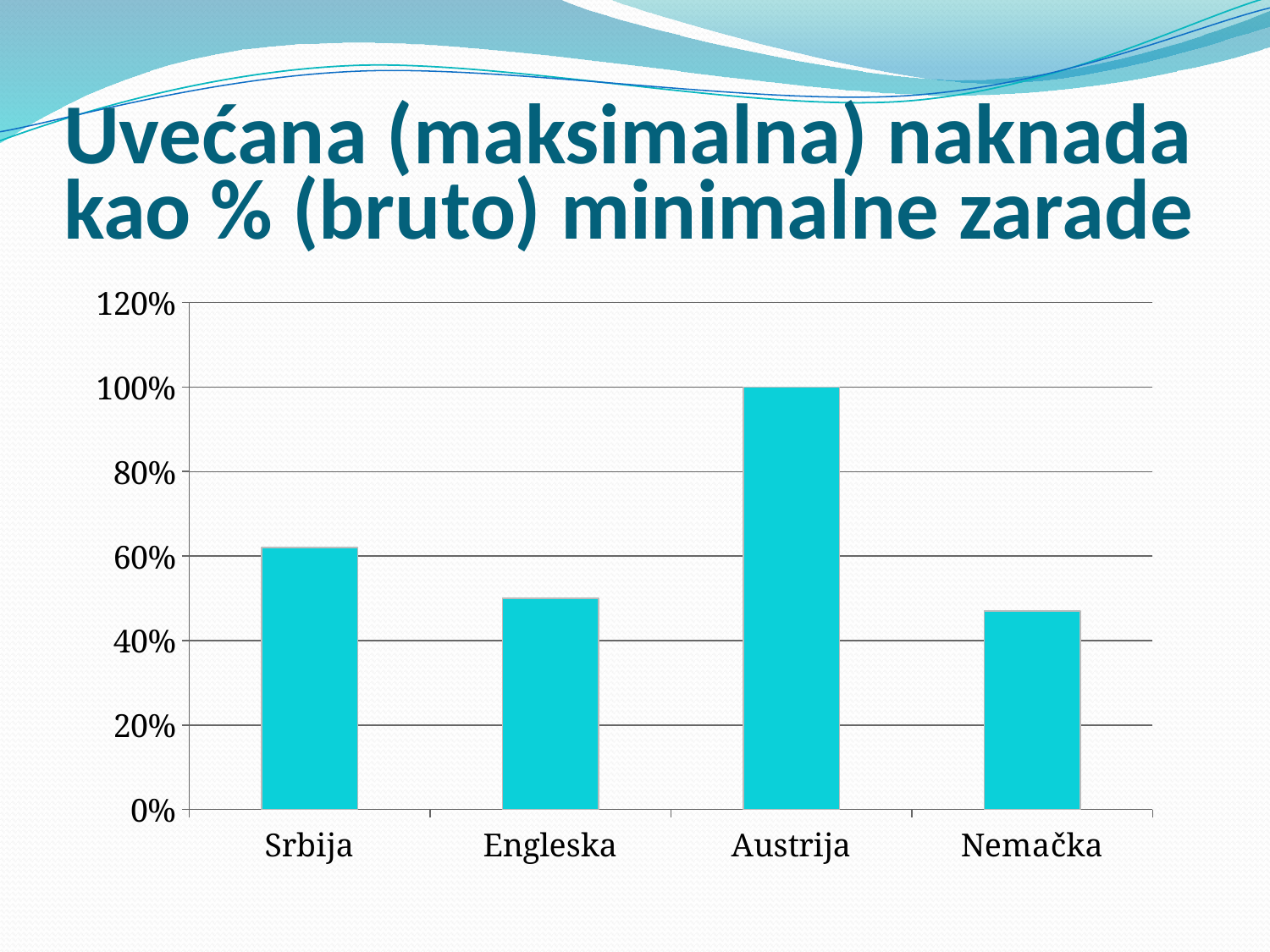
Which has a larger value, Austrija or Nemačka? Austrija What is the title of the slide containing the chart? Uvećana (maksimalna) naknada kao % (bruto) minimalne zarade Is the value for Austrija greater or less than 80%? greater Which country has the highest value in the chart? Austrija Is the value for Srbija greater or less than 40%? greater Is the value for Engleska greater or less than 40%? greater How many countries are shown on the x axis of the chart? 4 What kind of chart is shown on the slide? bar chart What is the value for Austrija? 100% Which has a larger value, Srbija or Engleska? Srbija